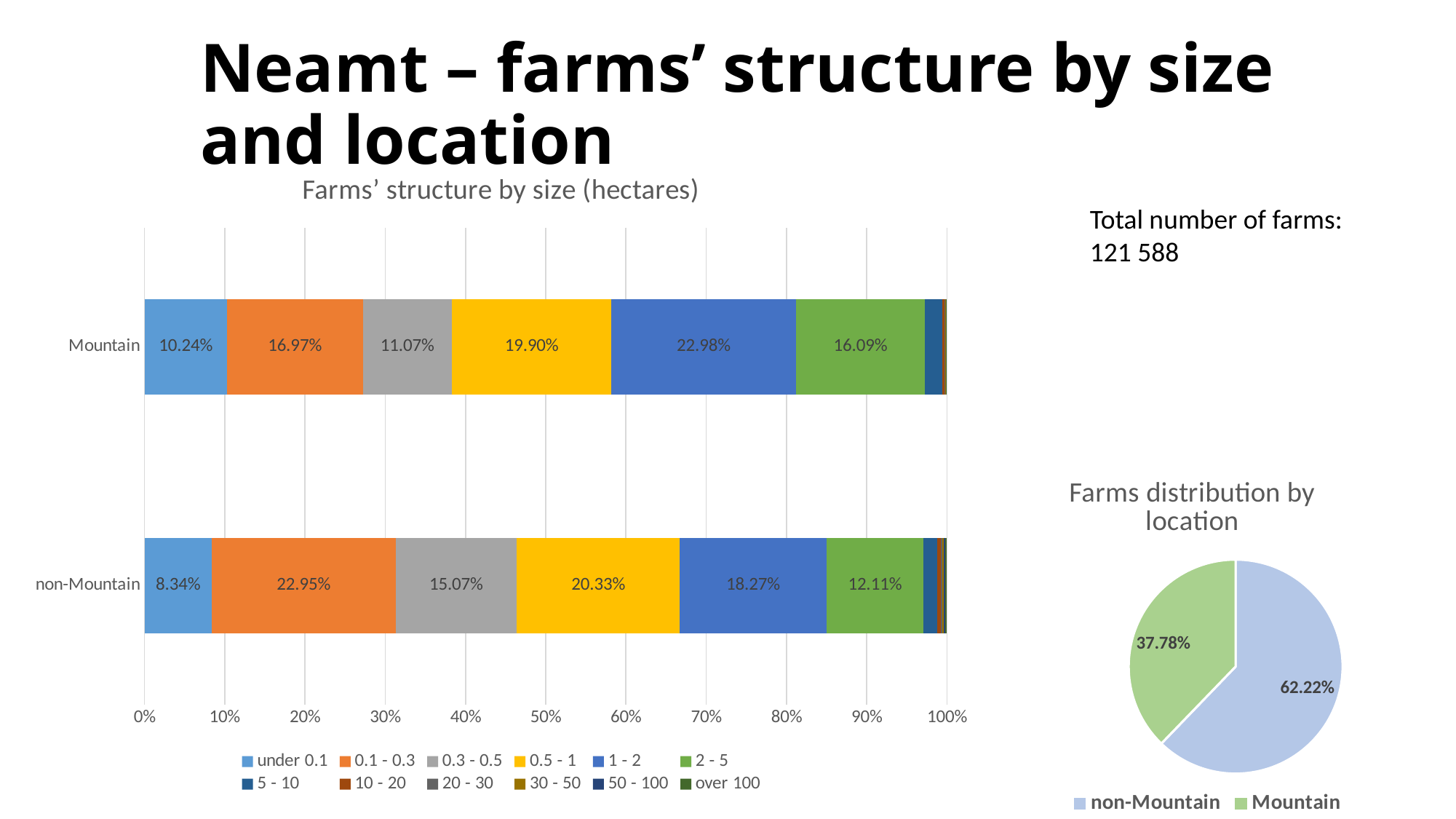
In the 'Farms' structure by size (hectares)' chart, is the '2 - 5' share larger for Mountain or for non-Mountain? Mountain In the 'Farms' structure by size (hectares)' chart, what is the value of the 'under 0.1' segment for Mountain? 10.24% In the 'Farms distribution by location' pie chart, what share do non-Mountain farms have? 62.22% In the 'Farms' structure by size (hectares)' chart, what is the value of the '0.1 - 0.3' segment for non-Mountain? 22.95% How many series does the legend of the 'Farms' structure by size (hectares)' chart list? 12 In the 'Farms distribution by location' pie chart, what is the difference between the non-Mountain and Mountain shares? 24.44 percentage points What total number of farms is stated on the slide? 121 588 In the 'Farms' structure by size (hectares)' chart, what is the difference between the '1 - 2' share for Mountain and for non-Mountain? 4.71 percentage points What kind of chart is 'Farms' structure by size (hectares)'? Stacked bar chart In the 'Farms' structure by size (hectares)' chart, what is the value of the '1 - 2' segment for Mountain? 22.98% In the 'Farms' structure by size (hectares)' chart, which labelled size class has the smallest share for non-Mountain farms? under 0.1 In the 'Farms' structure by size (hectares)' chart, which labelled size class has the largest share for Mountain farms? 1 - 2